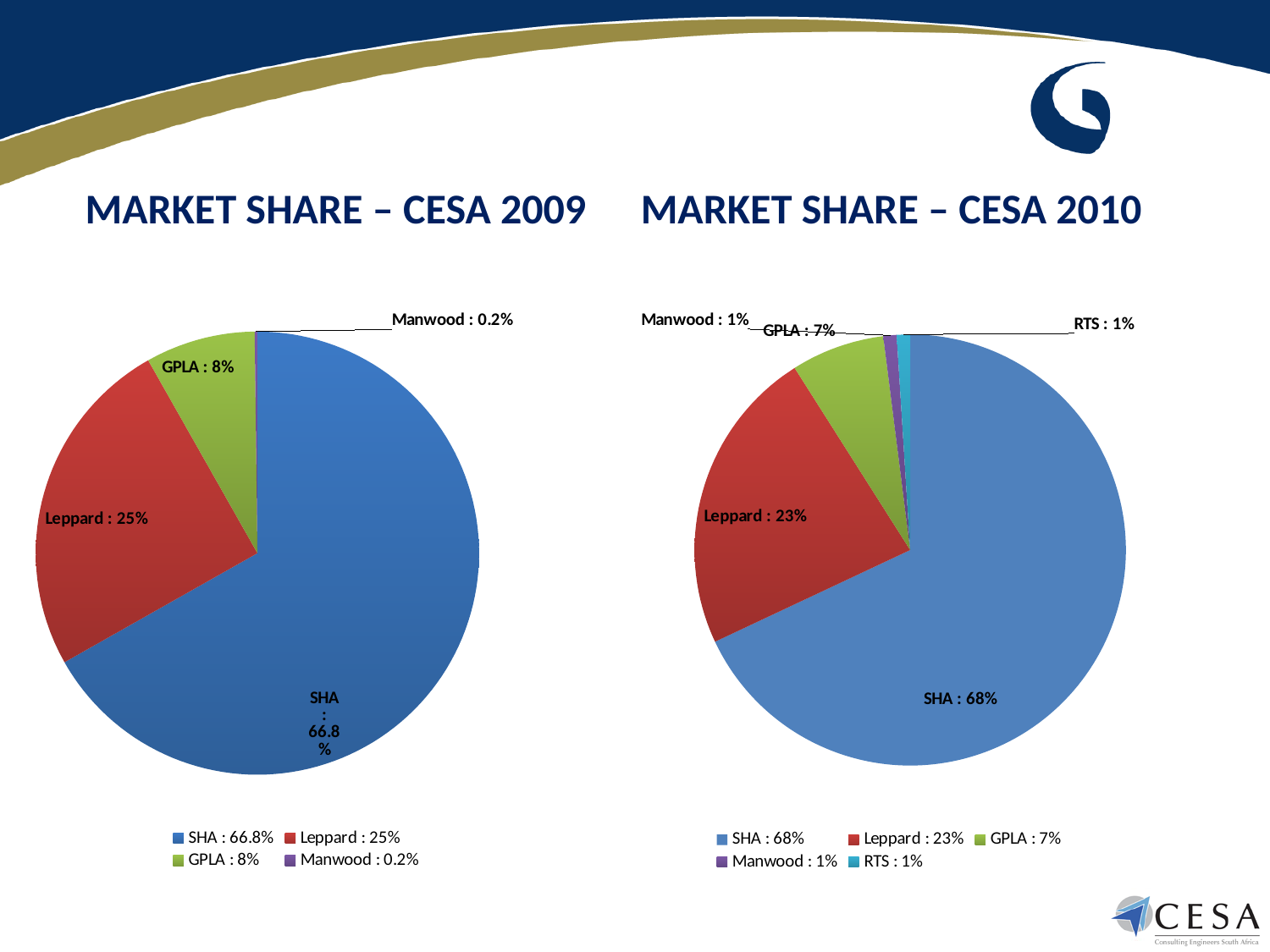
What type of chart is used for MARKET SHARE – CESA 2009? Pie chart In the MARKET SHARE – CESA 2009 chart, what is the difference between Leppard's share and GPLA's share? 17% In the MARKET SHARE – CESA 2009 chart, which company has the smallest share? Manwood How many slices does the MARKET SHARE – CESA 2010 pie chart have? 5 Which company appears in the MARKET SHARE – CESA 2010 chart but not in the MARKET SHARE – CESA 2009 chart? RTS In the MARKET SHARE – CESA 2009 chart, what share does Manwood hold? 0.2% How many entries does the legend of the MARKET SHARE – CESA 2009 chart list? 4 In the MARKET SHARE – CESA 2010 chart, which company has the largest share? SHA In the MARKET SHARE – CESA 2010 chart, what share does GPLA hold? 7% In the MARKET SHARE – CESA 2010 chart, what share does Leppard hold? 23% In the MARKET SHARE – CESA 2010 chart, which is larger, Leppard's share or GPLA's share? Leppard In the MARKET SHARE – CESA 2009 chart, what share does SHA hold? 66.8%